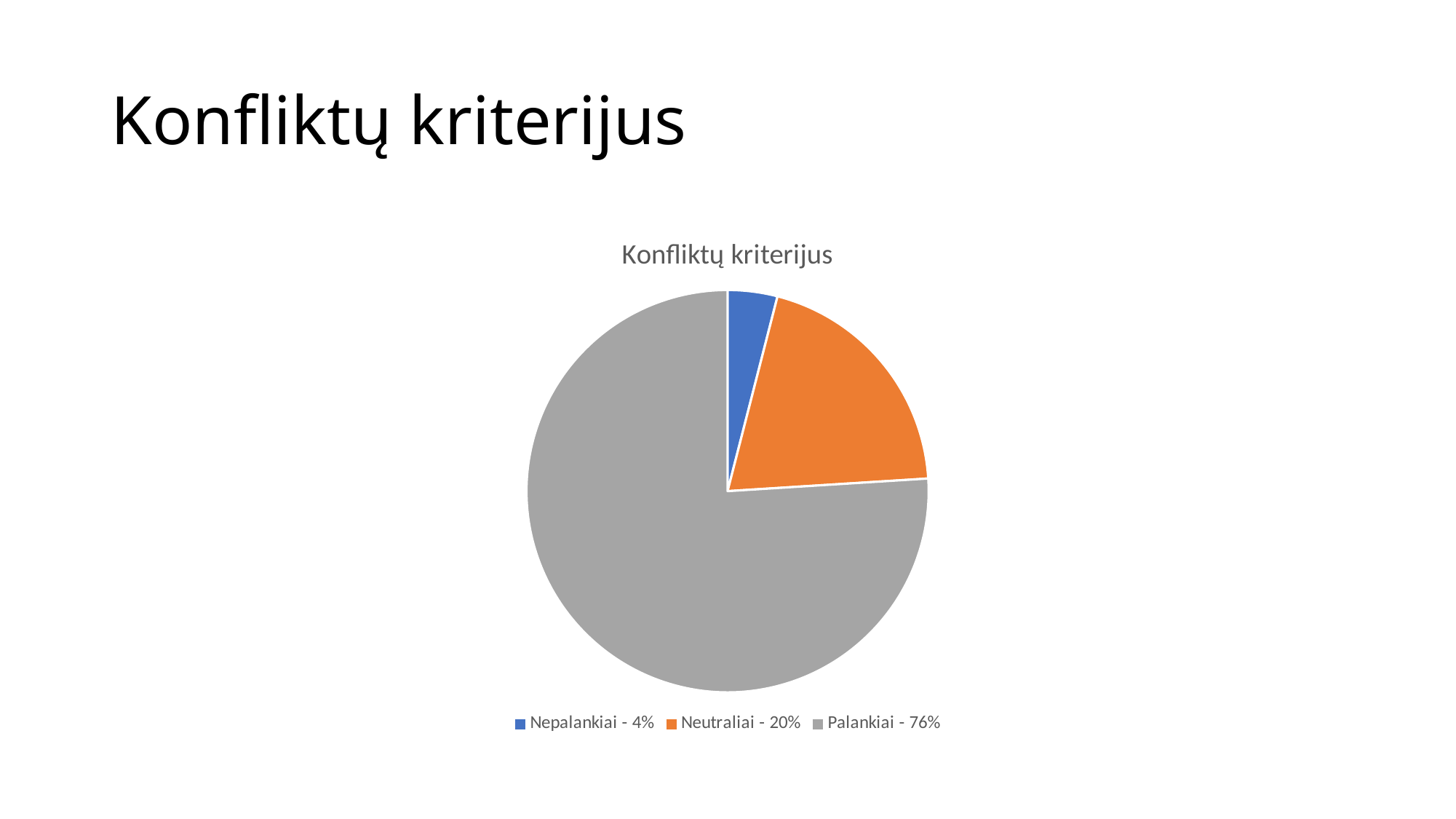
Which is larger, the Neutraliai slice or the Nepalankiai slice? Neutraliai What colour is the Palankiai slice in the pie chart? Grey What share of the pie does the Nepalankiai slice represent? 4% What kind of chart is shown on the slide? Pie chart Which category has the largest slice of the pie? Palankiai What is the title of the chart? Konfliktų kriterijus What share of the pie does the Neutraliai slice represent? 20% Which category has the smallest slice of the pie? Nepalankiai What is the difference in percentage points between the Palankiai and Neutraliai slices? 56 What is the difference in percentage points between the Neutraliai and Nepalankiai slices? 16 What share of the pie does the Palankiai slice represent? 76% How many slices does the pie chart have? 3